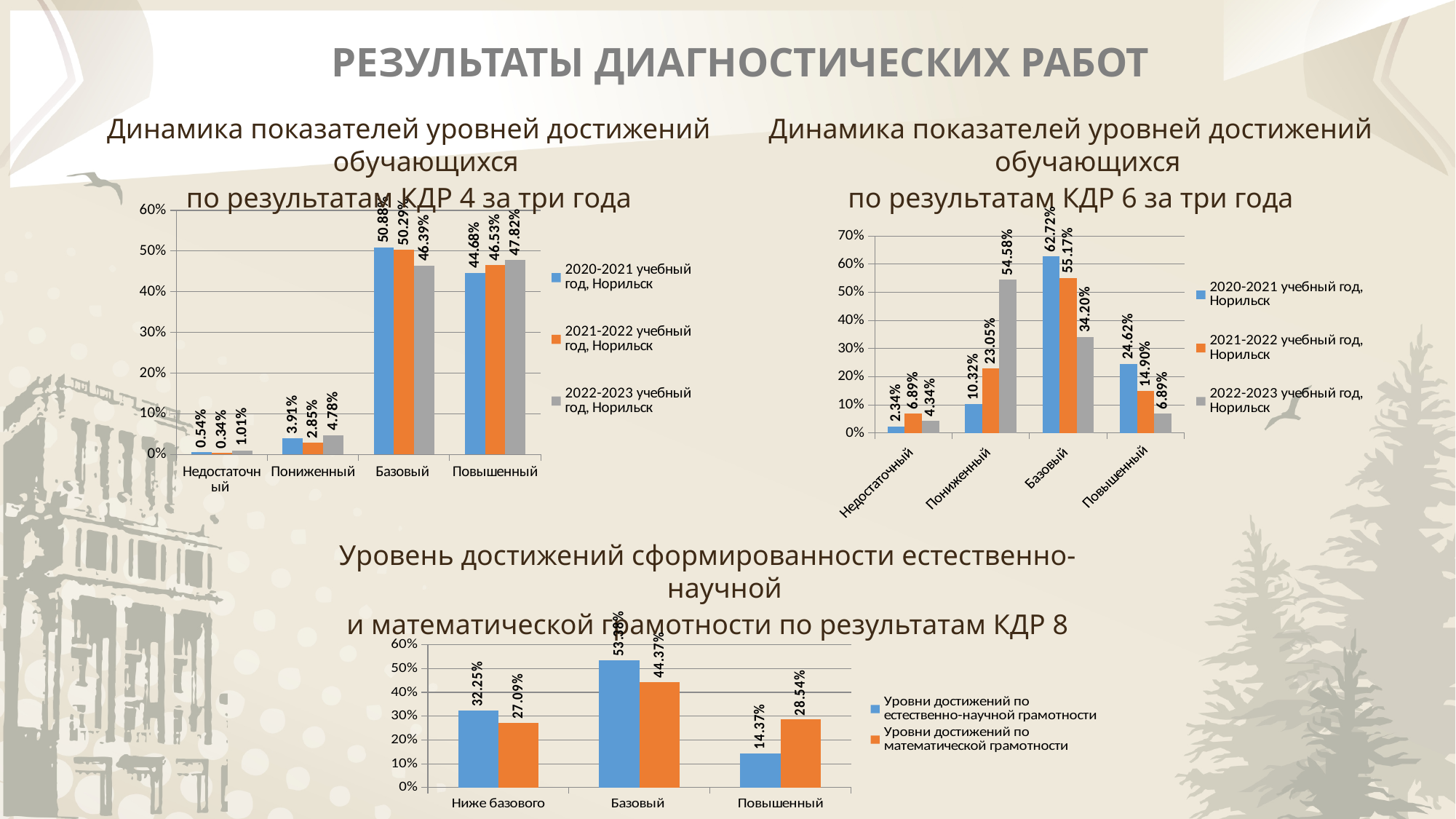
What type of chart is the bottom chart about КДР 8? bar chart In the chart 'по результатам КДР 6 за три года', do the values for Повышенный rise or fall from 2020-2021 to 2022-2023? fall In the chart 'по результатам КДР 4 за три года', what is the value for Повышенный in the 2022-2023 учебный год series? 47.82% In the chart 'по результатам КДР 6 за три года', how many categories are shown on the x axis? 4 In the bottom chart about КДР 8, what is the value for Повышенный in the математической грамотности series? 28.54% In the chart 'по результатам КДР 4 за три года', what is the value for Базовый in the 2020-2021 учебный год series? 50.88% In the chart 'по результатам КДР 6 за три года', what is the value for Пониженный in the 2022-2023 учебный год series? 54.58% In the chart 'по результатам КДР 6 за три года', which category has the highest value in the 2020-2021 учебный год series? Базовый In the chart 'по результатам КДР 6 за три года', what is the difference between the 2020-2021 and 2022-2023 values for Базовый? 28.52% In the bottom chart about КДР 8, which is larger for Ниже базового: естественно-научной грамотности or математической грамотности? естественно-научной грамотности In the chart 'по результатам КДР 4 за три года', which category has the lowest value in the 2021-2022 учебный год series? Недостаточный In the chart 'по результатам КДР 4 за три года', how many series does the legend list? 3